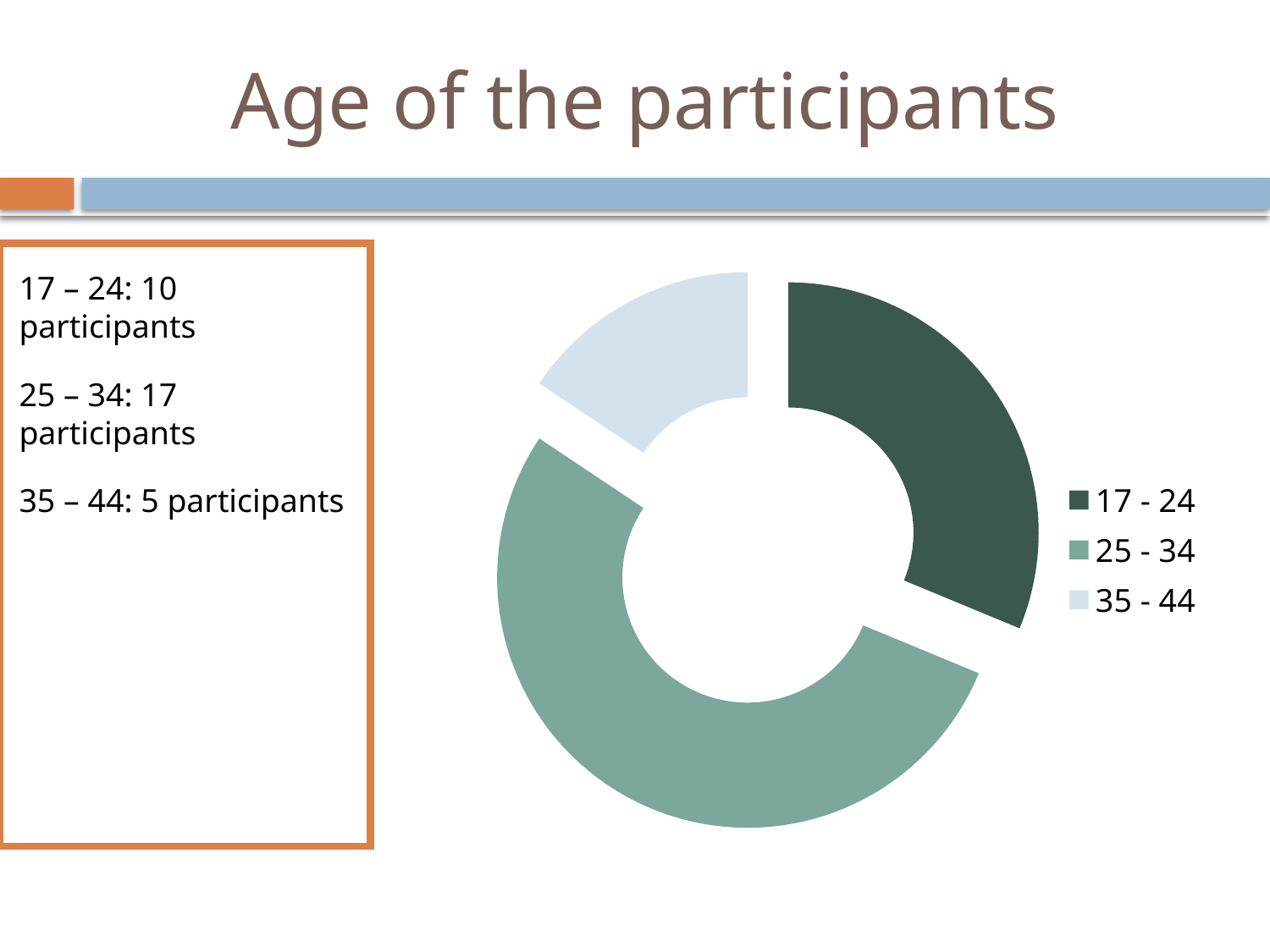
How many entries does the chart's legend list? 3 How many participants are in the 35 - 44 age group? 5 participants What is the title of the slide containing the chart? Age of the participants Which age group has more participants, 17 - 24 or 35 - 44? 17 - 24 How many participants are in the 25 - 34 age group? 17 participants What is the total number of participants across all three age groups? 32 How many participants are in the 17 - 24 age group? 10 participants How many more participants are in the 25 - 34 group than in the 17 - 24 group? 7 What kind of chart is shown on the slide? doughnut chart How many age groups does the chart show? 3 Which age group has the largest share of the chart? 25 - 34 Which age group has the smallest share of the chart? 35 - 44